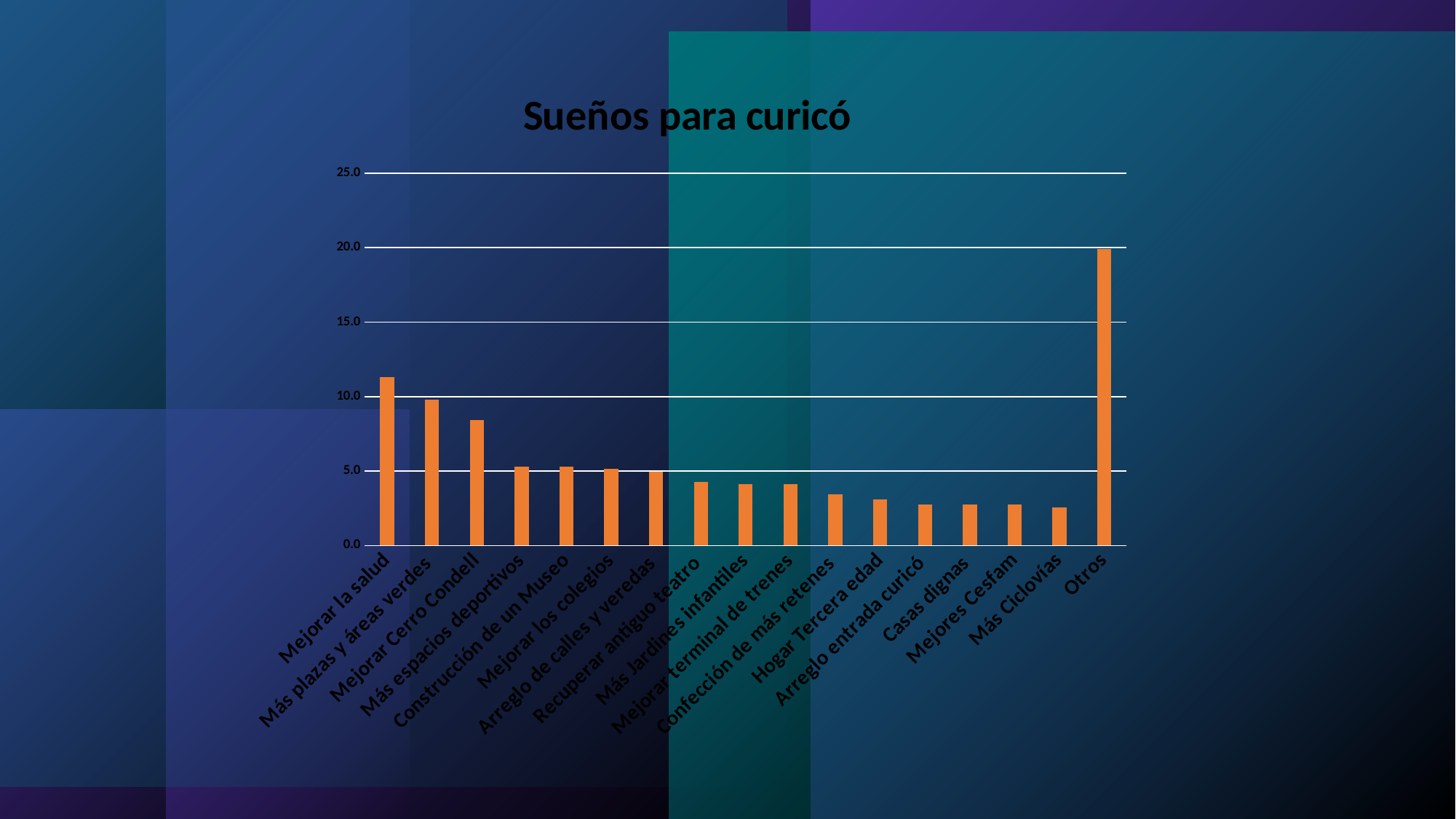
Which is larger, the value for Otros or the value for Mejorar la salud? Otros Which category has the highest bar? Otros Is the value for Mejorar la salud greater or less than 10.0? greater What is the title of the chart? Sueños para curicó Is the value for Otros greater or less than 15.0? greater What colour are the bars in the chart? orange How many categories are plotted on the x axis? 17 Which is larger, the value for Mejorar la salud or the value for Mejorar Cerro Condell? Mejorar la salud Is the value for Recuperar antiguo teatro greater or less than 5.0? less What kind of chart is shown on the slide? bar chart